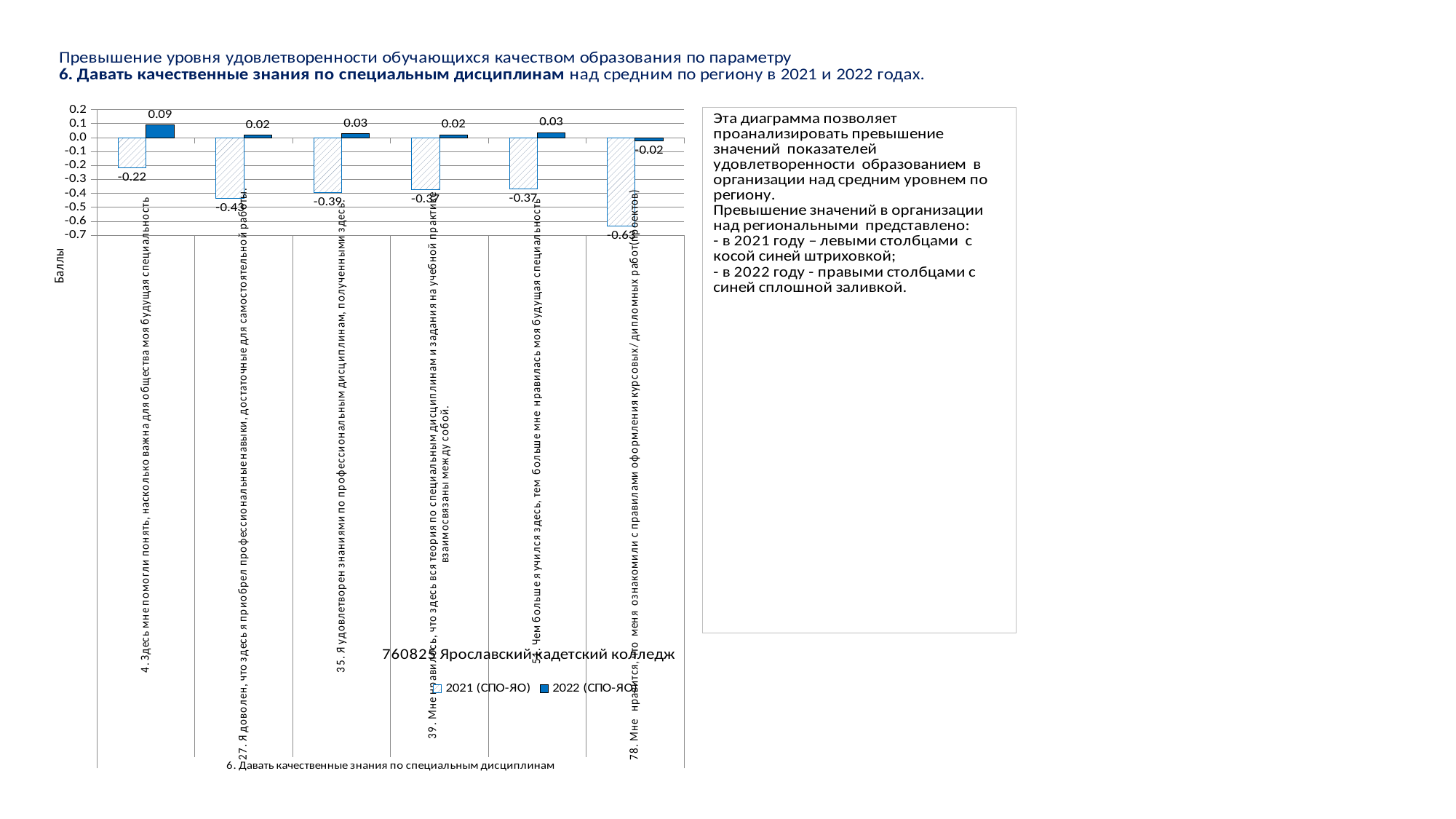
Which is larger, the 2021 value for item 27 or the 2021 value for item 35? Item 35 (-0.39) What is the 2022 (СПО-ЯО) value for item 78? -0.02 How many categories (items) are shown on the chart? 6 How many series does the legend list? 2 What is the 2021 (СПО-ЯО) value for item 27 ("Я доволен, что здесь я приобрел профессиональные навыки...")? -0.43 For item 4, what is the difference between the 2022 value and the 2021 value? 0.31 Which item has the lowest 2021 (СПО-ЯО) value? Item 78 (-0.63) What is the 2021 (СПО-ЯО) value for item 78 ("Мне нравится, что меня ознакомили с правилами оформления курсовых/дипломных работ")? -0.63 Which item has the lowest 2022 (СПО-ЯО) value? Item 78 (-0.02) What is the 2022 (СПО-ЯО) value for item 4 ("Здесь мне помогли понять, насколько важна для общества моя будущая специальность")? 0.09 What type of chart is shown on the slide? Bar chart Which item has the highest 2022 (СПО-ЯО) value? Item 4 (0.09)